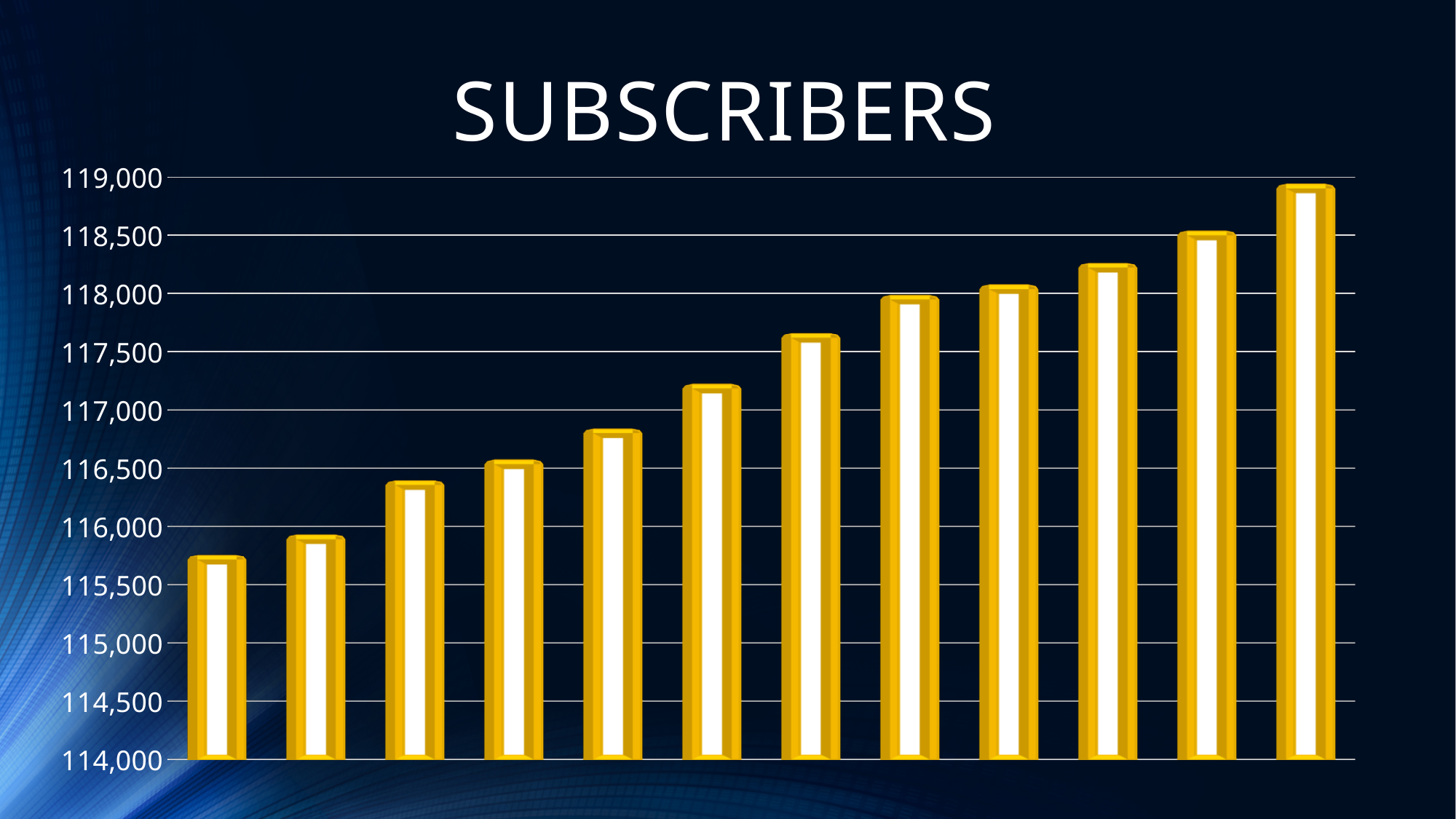
What is the title of the chart? SUBSCRIBERS How many bars are plotted in the chart? 12 Which bar is the tallest in the chart? the rightmost (last) bar Is the value of the fifth bar from the left greater or less than 117,000? less Is the value of the tenth bar from the left greater or less than 118,500? less Do the bar values rise or fall from left to right across the chart? rise Which is larger, the value of the third bar from the left or the value of the seventh bar from the left? the seventh bar Is the value of the last (rightmost) bar greater or less than 118,500? greater Which bar is the shortest in the chart? the leftmost (first) bar What is the lowest value shown on the vertical axis? 114,000 What kind of chart is shown on the slide? bar chart